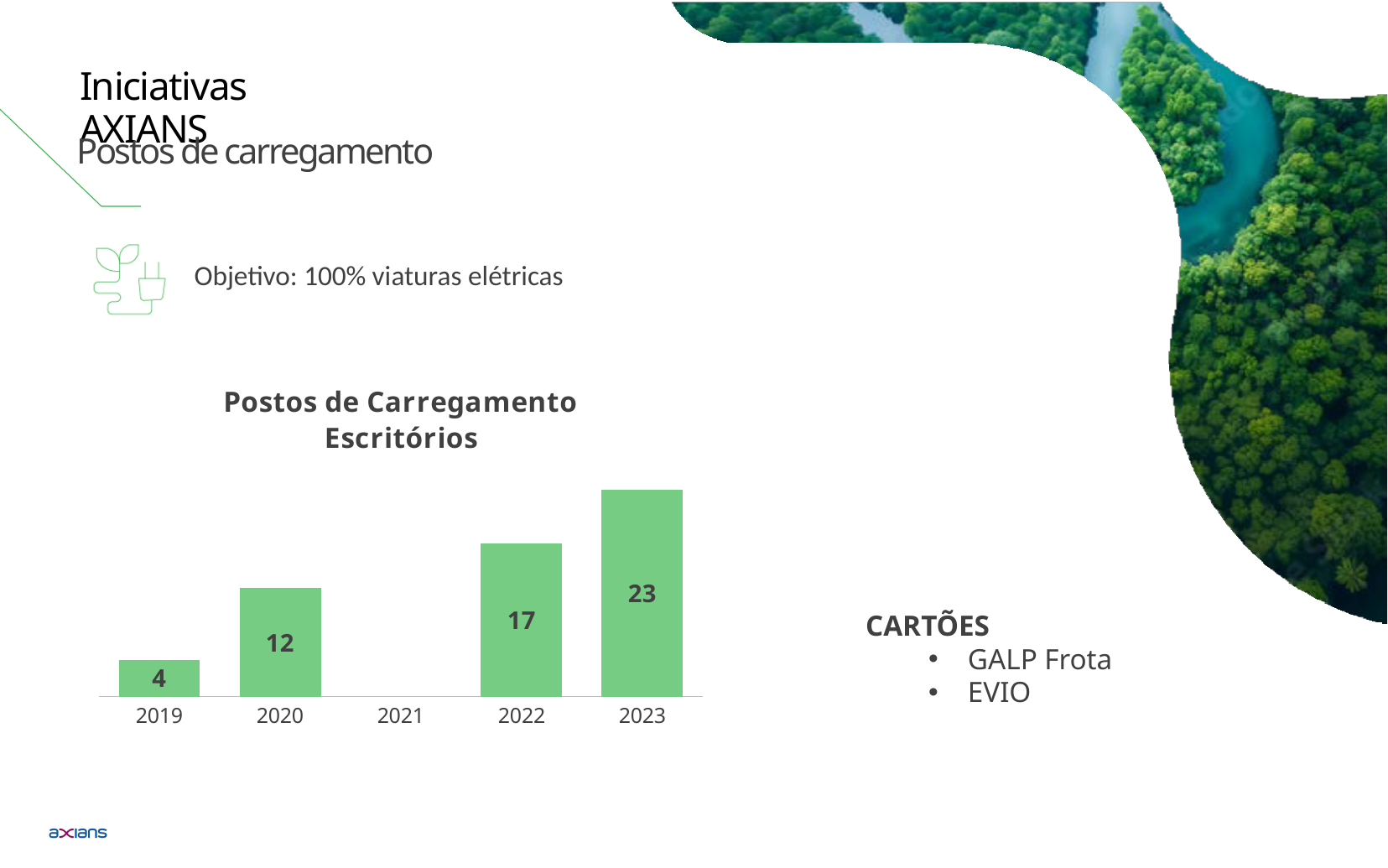
What is the value for 2020 in the Postos de Carregamento Escritórios chart? 12 What kind of chart is the Postos de Carregamento Escritórios chart? Bar chart What is the value for 2023 in the Postos de Carregamento Escritórios chart? 23 Which year with a labelled bar has the lowest value in the Postos de Carregamento Escritórios chart? 2019 In the Postos de Carregamento Escritórios chart, which is larger: the value for 2020 or the value for 2022? 2022 How many years are labelled on the x axis of the Postos de Carregamento Escritórios chart? 5 What is the difference between the values for 2020 and 2019 in the Postos de Carregamento Escritórios chart? 8 Which year has the highest value in the Postos de Carregamento Escritórios chart? 2023 What is the value for 2019 in the Postos de Carregamento Escritórios chart? 4 What is the difference between the values for 2023 and 2022 in the Postos de Carregamento Escritórios chart? 6 Do the labelled values in the Postos de Carregamento Escritórios chart rise or fall from 2019 to 2023? Rise What is the value for 2022 in the Postos de Carregamento Escritórios chart? 17